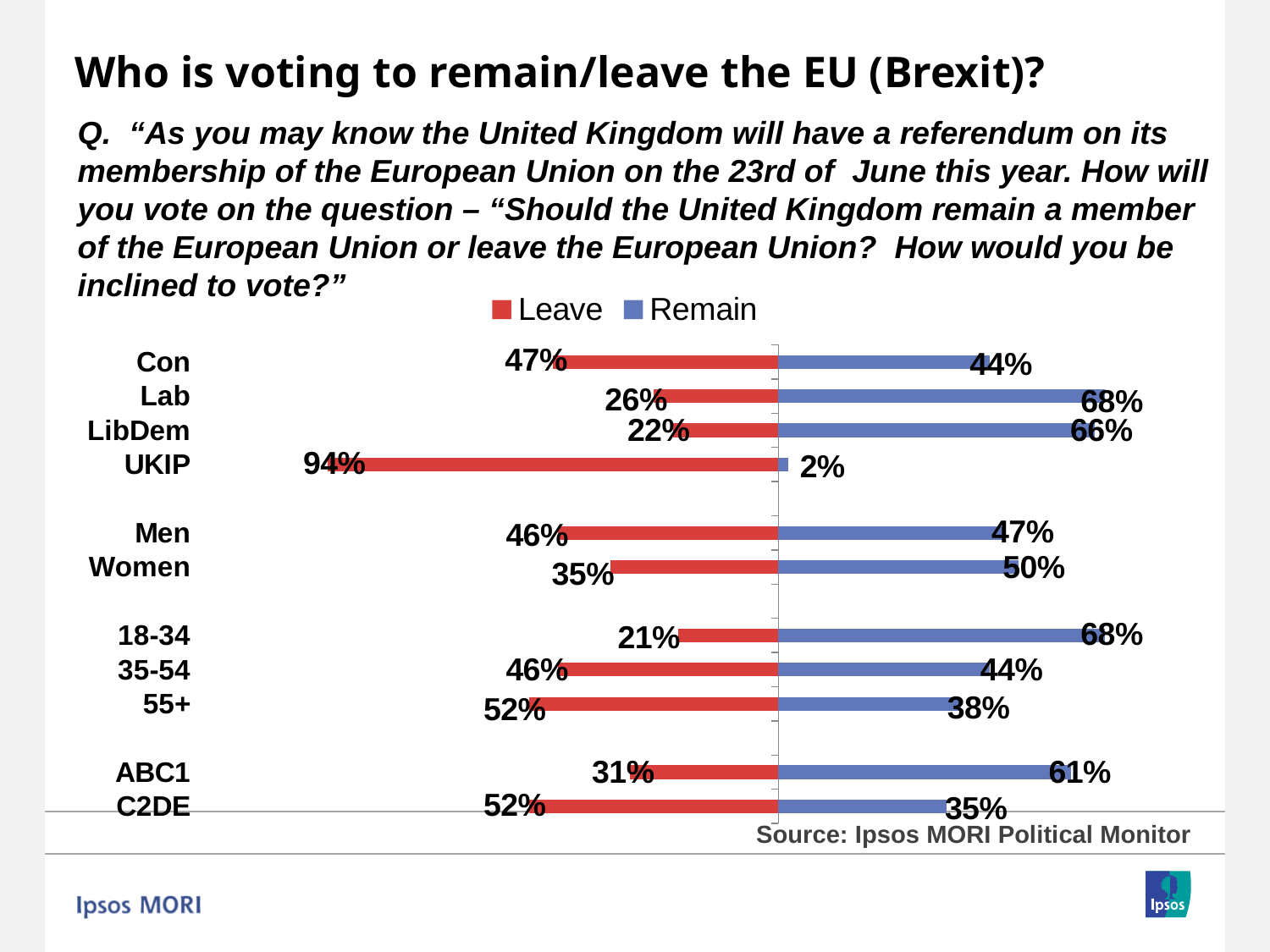
Which is larger for 55+, the Leave value or the Remain value? Leave Which category has the lowest Remain value? UKIP What is the difference between the Remain and Leave values for 18-34? 47% What is the Leave value for UKIP? 94% What kind of chart is shown on the slide? Bar chart What is the Leave value for Women? 35% What is the Remain value for ABC1? 61% Which colour represents Remain in the chart? Blue How many categories are shown on the chart? 11 How many series does the legend list? 2 Which category has the highest Leave value? UKIP What is the Remain value for Lab? 68%